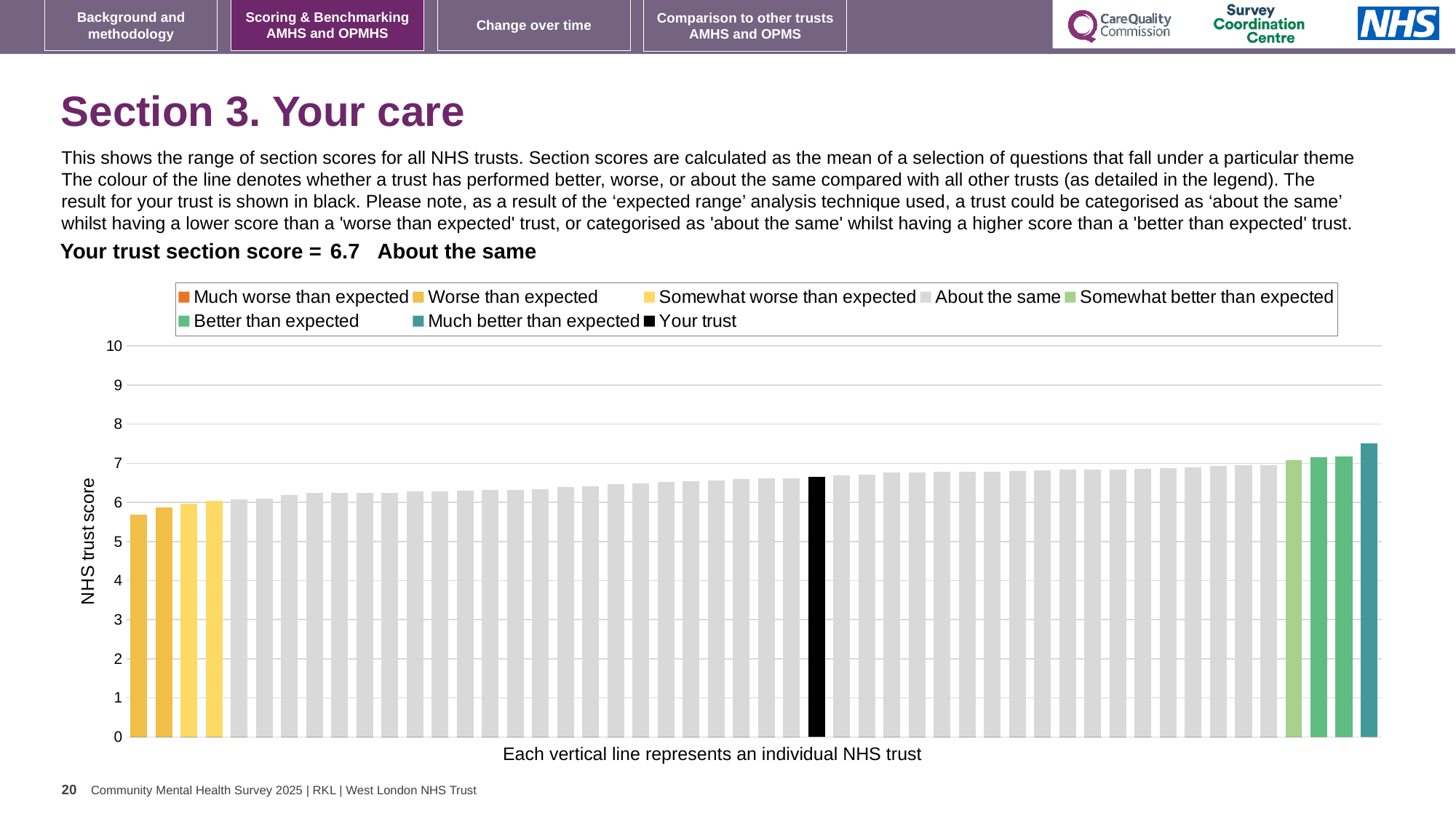
Is the value for the highest bar on the chart greater or less than 7? greater Do the bar values rise or fall from left to right along the x axis? rise What is the title of the vertical axis of the chart? NHS trust score Is the value for the lowest bar on the chart greater or less than 6? less How many bars are coloured as 'Better than expected' (green)? 2 Is the value for your trust (the black bar) greater or less than 6? greater Which legend category does the highest bar on the chart belong to? Much better than expected What kind of chart is shown on the slide? bar chart What is the section score for your trust shown on the slide? 6.7 Which legend category does the lowest bar on the chart belong to? Worse than expected How many entries does the chart legend list? 8